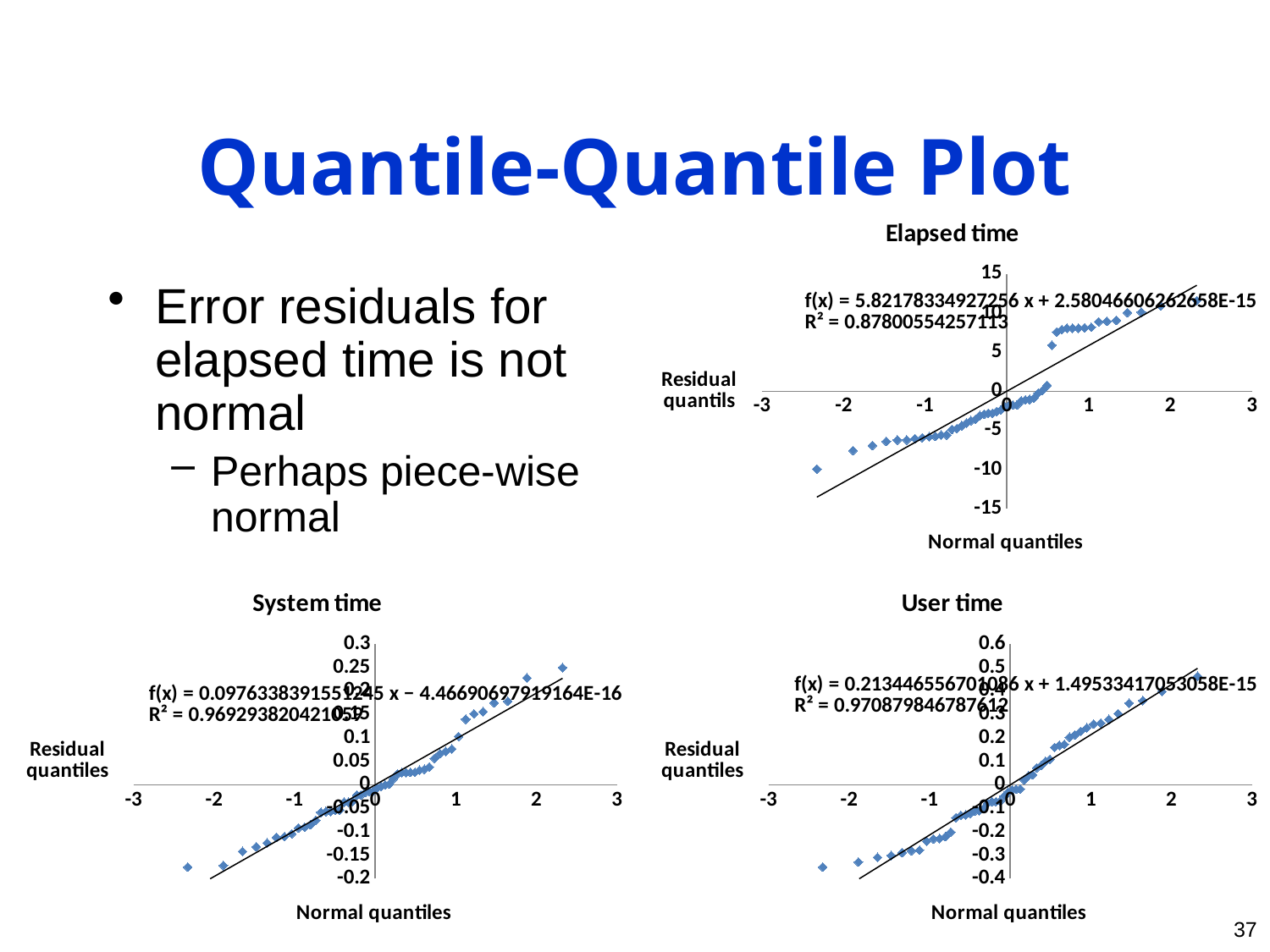
In the "System time" chart, is the residual quantile of the leftmost point greater or less than -0.1? less What is the x-axis label of the "System time" chart? Normal quantiles In the "User time" chart, is the residual quantile of the rightmost point greater or less than 0.3? greater What is the title of the chart in the top right of the slide? Elapsed time In the "User time" chart, do the plotted points rise or fall from left to right? Rise How many charts are shown on the slide? 3 In the "Elapsed time" chart, is the residual quantile of the leftmost point greater or less than -5? less In the "Elapsed time" chart, do the residual quantiles rise or fall as the normal quantiles increase? Rise What is the highest tick value on the y-axis of the "Elapsed time" chart? 15 What kind of chart is the "Elapsed time" chart? Scatter chart